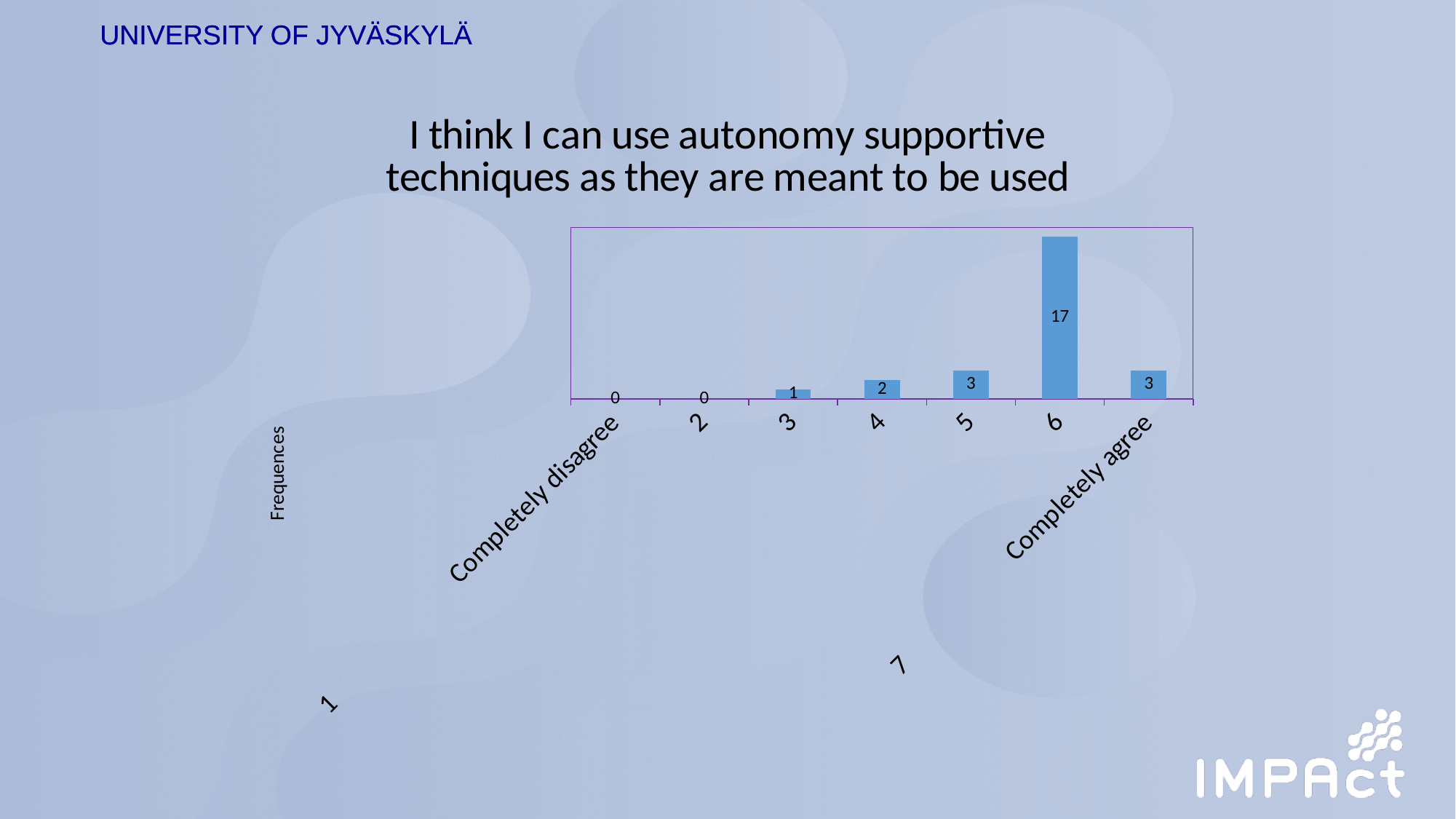
What is the value for the 'Completely disagree' category? 0 Which category has the highest value? 6 What is the value for the 'Completely agree' category? 3 Which is larger, the value for category 3 or the value for category 5? Category 5 What is the title of the chart? I think I can use autonomy supportive techniques as they are meant to be used How many categories are shown on the x axis? 7 What is the label of the vertical axis? Frequences What is the difference between the values for category 4 and category 3? 1 What is the difference between the values for category 6 and category 5? 14 What kind of chart is shown on the slide? Bar chart What is the value for category 4? 2 What is the value for category 6? 17